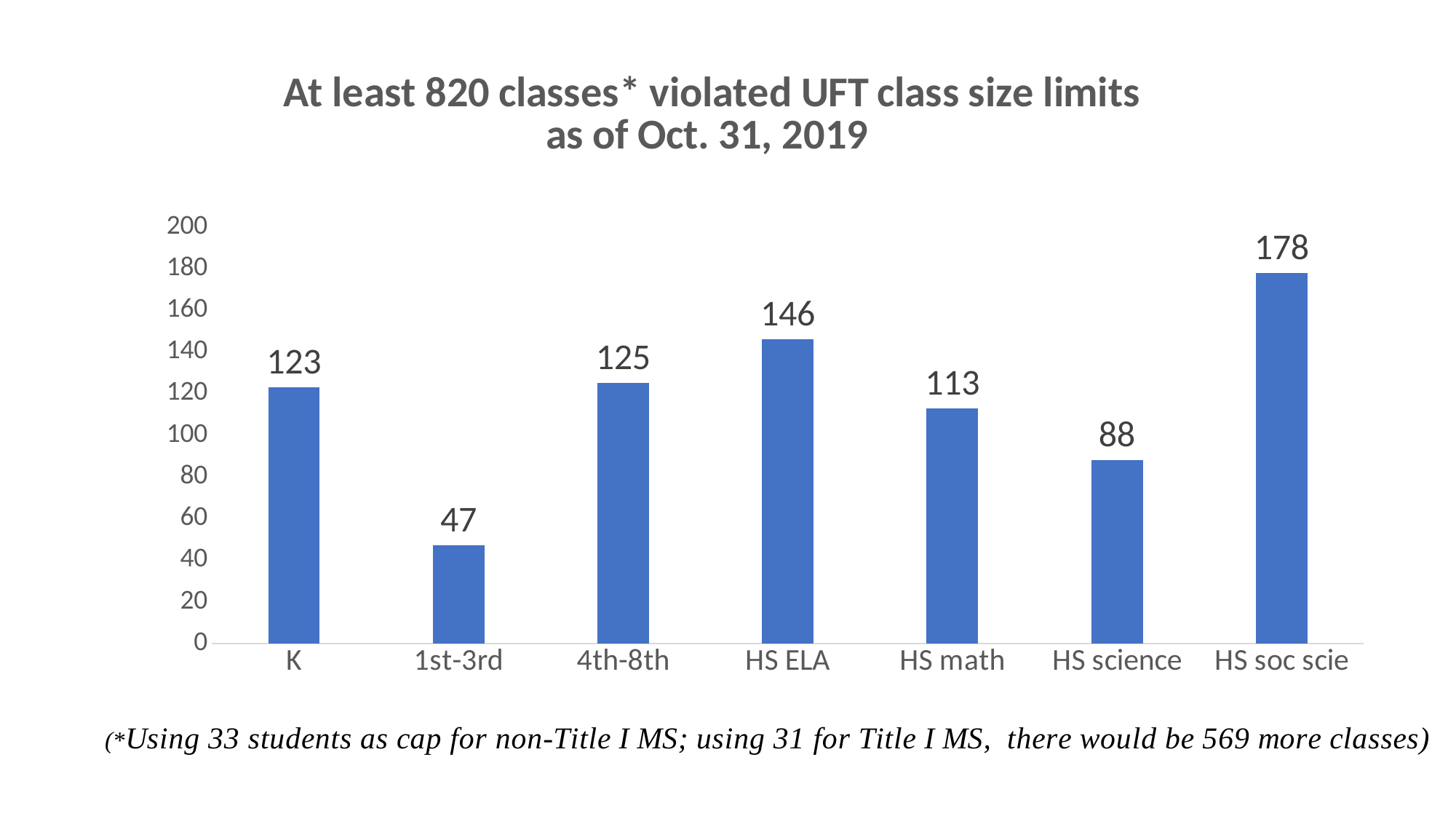
What is the value for 1st-3rd? 47 What is the difference between the values for K and 1st-3rd? 76 What is the title of the chart? At least 820 classes* violated UFT class size limits as of Oct. 31, 2019 What is the value for HS science? 88 How many categories are shown on the x axis? 7 Which is larger, the value for HS math or the value for HS science? HS math Which category has the highest value? HS soc scie What is the value for HS ELA? 146 Which category has the lowest value? 1st-3rd Is the value for 4th-8th greater or less than 100? greater What kind of chart is this? bar chart What is the difference between the values for HS soc scie and HS ELA? 32